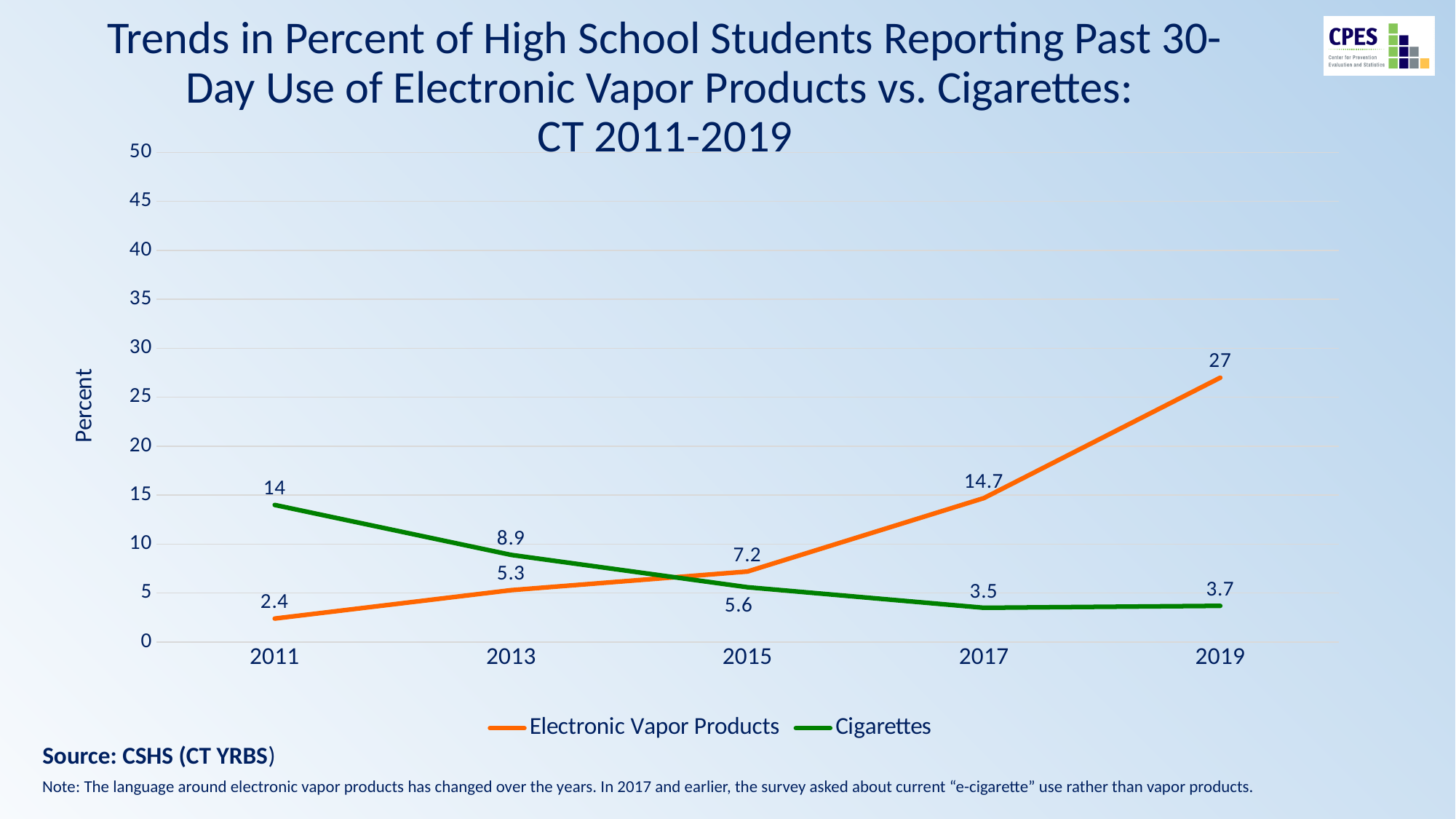
What percent of high school students reported past 30-day use of Electronic Vapor Products in 2019? 27 In 2013, which is larger: the Electronic Vapor Products value or the Cigarettes value? Cigarettes What percent of high school students reported past 30-day use of Cigarettes in 2011? 14 What is the difference between the Electronic Vapor Products value and the Cigarettes value in 2019? 23.3 In which year is the Electronic Vapor Products value highest? 2019 How many series does the legend list? 2 What is the value for Cigarettes in 2017? 3.5 What is the value for Electronic Vapor Products in 2015? 7.2 Does the Cigarettes line generally rise or fall from 2011 to 2019? Fall In which year is the Cigarettes value lowest? 2017 How many years are plotted on the x axis? 5 What kind of chart is shown on the slide? Line chart